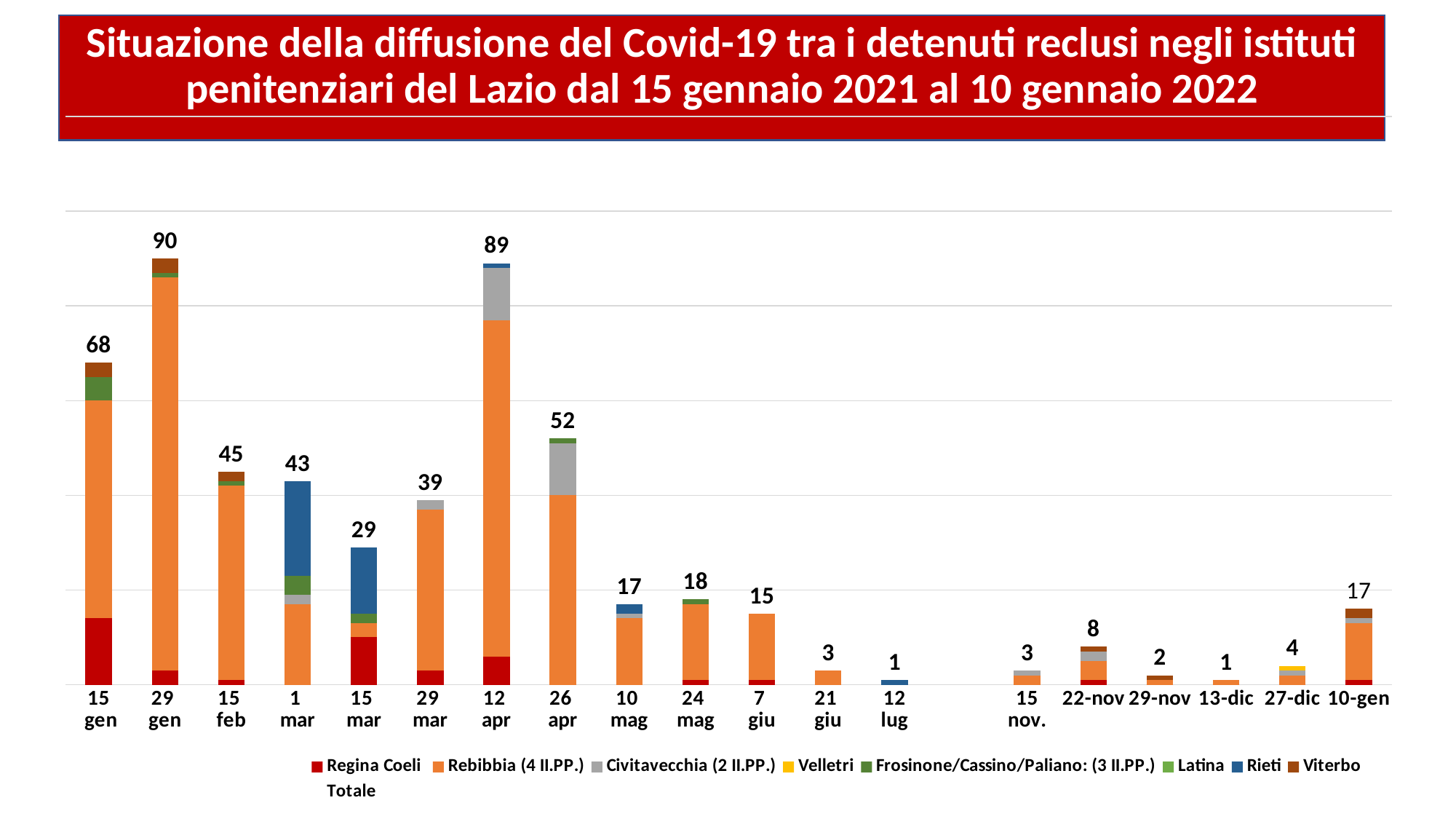
What is the total value shown for 29 gen? 90 Do the totals rise or fall from 12 apr to 12 lug? Fall What is the difference between the totals for 26 apr and 29 mar? 13 Which has a larger total, 1 mar or 15 mar? 1 mar How many entries does the legend list? 9 What is the total value shown for 12 apr? 89 How many dates are shown on the x axis? 19 Which date has the highest total? 29 gen What is the total value shown for 27-dic? 4 What kind of chart is shown on the slide? Stacked bar chart What is the total value shown for 10-gen? 17 What is the difference between the totals for 15 gen and 15 feb? 23